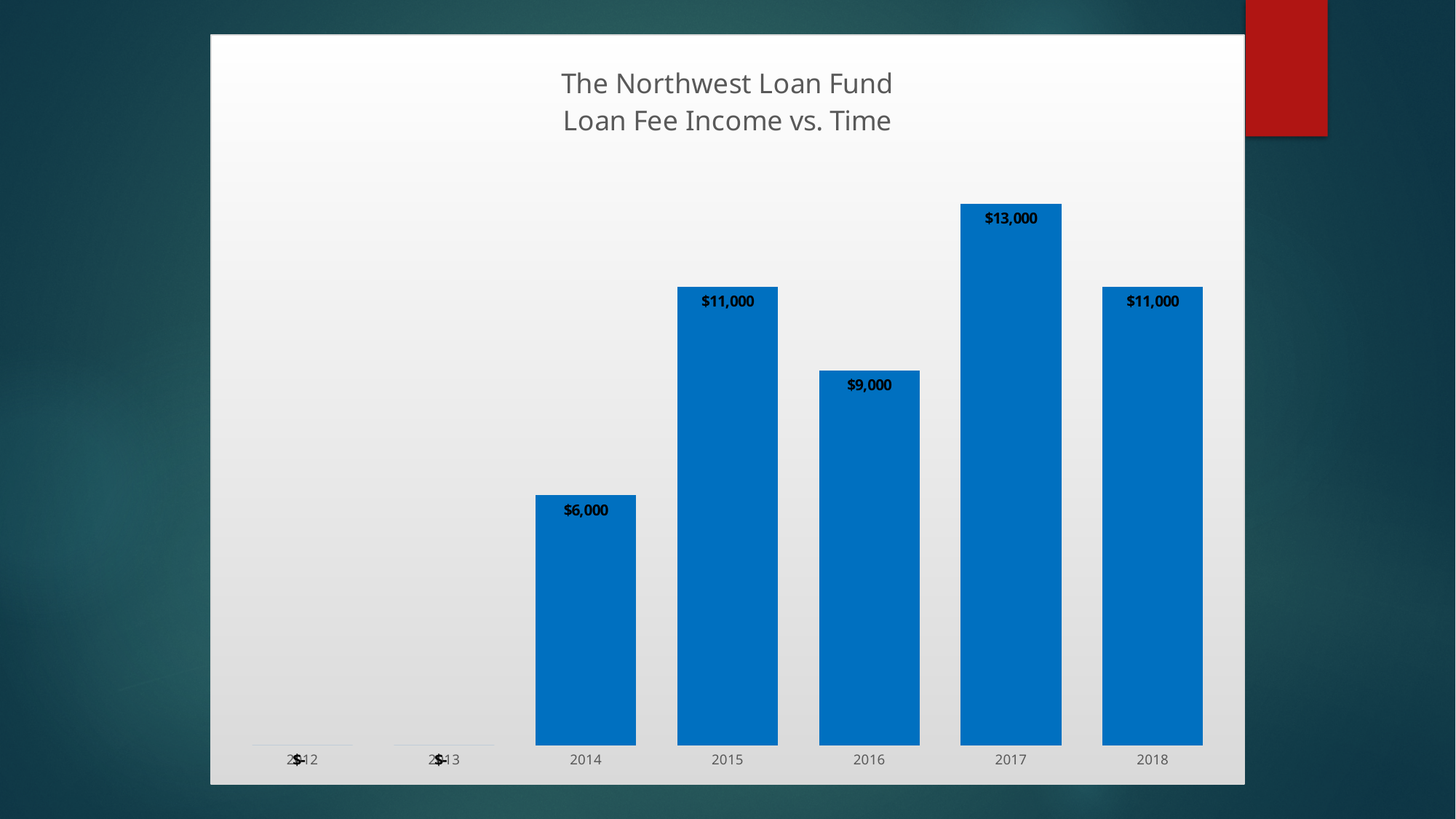
How many years are shown on the x axis of the chart? 7 Which year has the larger loan fee income, 2016 or 2018? 2018 What is the loan fee income for 2016? $9,000 Which year has the highest loan fee income? 2017 Among the years with a bar shown, which year has the lowest loan fee income? 2014 What is the loan fee income for 2014? $6,000 What is the title of the chart? The Northwest Loan Fund Loan Fee Income vs. Time What is the difference in loan fee income between 2017 and 2016? $4,000 What kind of chart is shown on the slide? Bar chart What is the loan fee income for 2018? $11,000 What is the difference in loan fee income between 2015 and 2014? $5,000 What is the loan fee income for 2017? $13,000